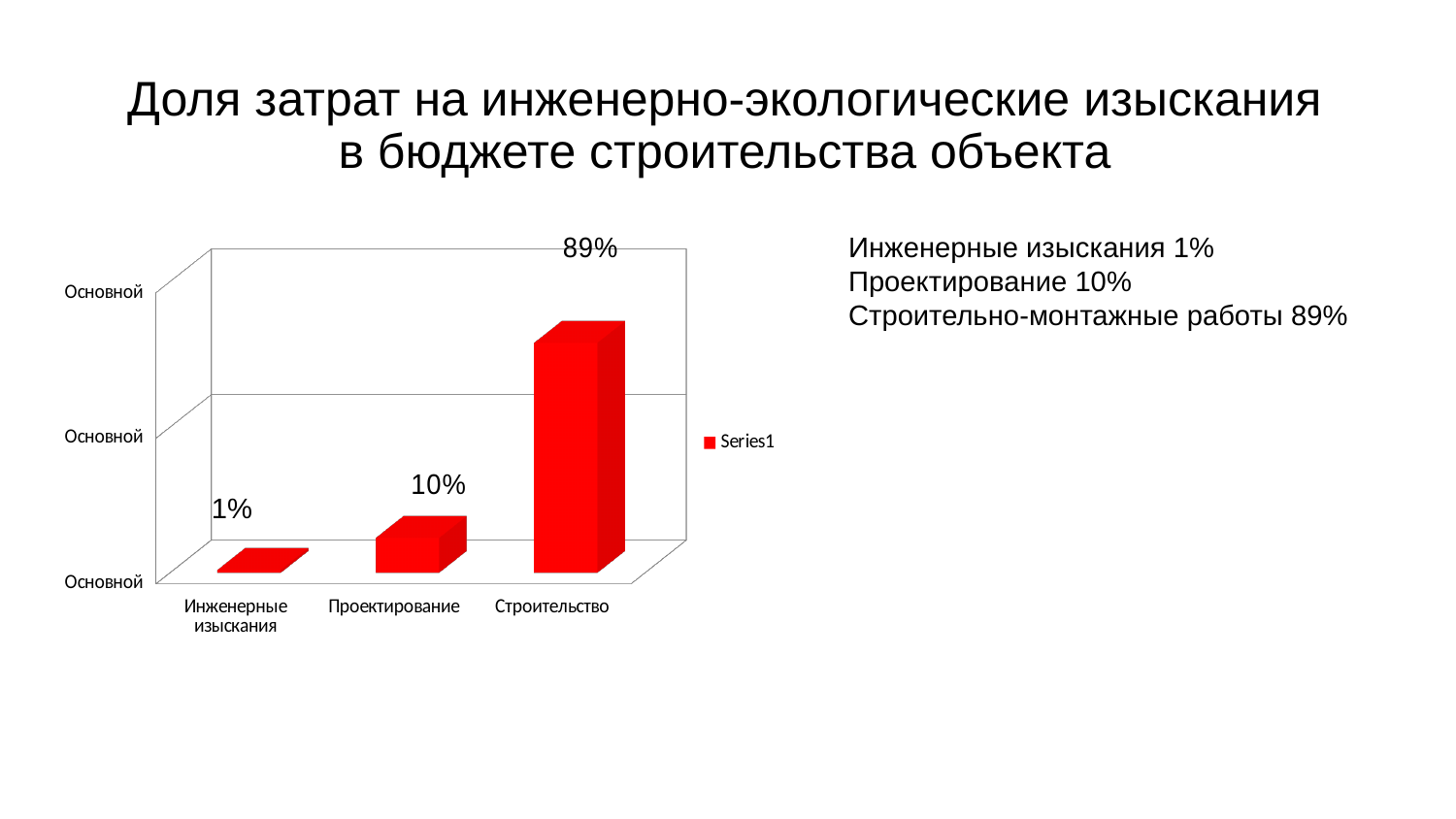
Which category has the lowest value? Инженерные изыскания What is the value for Инженерные изыскания? 1% Which is larger, the value for Проектирование or the value for Инженерные изыскания? Проектирование How many series does the legend list? 1 Do the values rise or fall from left to right along the x axis? Rise How many categories are shown on the x axis? 3 What is the difference between the values for Проектирование and Инженерные изыскания? 9% Which category has the highest value? Строительство What kind of chart is shown on the slide? Bar chart What is the difference between the values for Строительство and Проектирование? 79% What is the value for Строительство? 89% What is the value for Проектирование? 10%